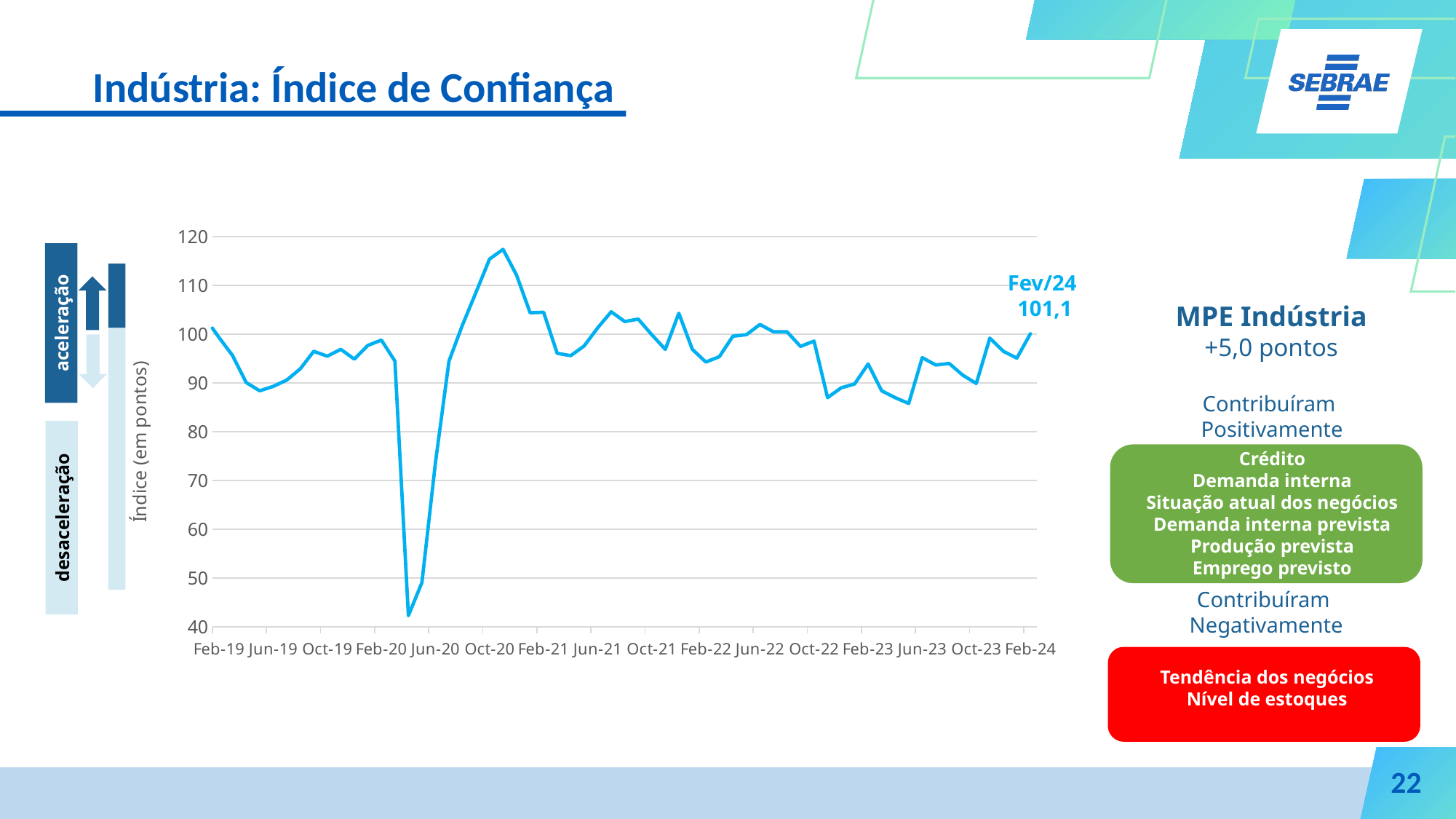
Is the value for Oct-20 greater or less than 110? greater Does the index rise or fall between Jun-20 and Oct-20? rise What kind of chart is used to show the Índice de Confiança? line chart Is the value for Feb-20 greater or less than 90? greater In which year does the index reach its lowest point? 2020 How many lines are plotted on the chart? 1 What is the label of the vertical axis of the chart? Índice (em pontos) What is the value of the confidence index for Fev/24 shown on the chart? 101,1 Does the index rise or fall between Feb-19 and Jun-19? fall Is the value for Jun-19 greater or less than 100? less In which year does the index reach its highest point? 2020